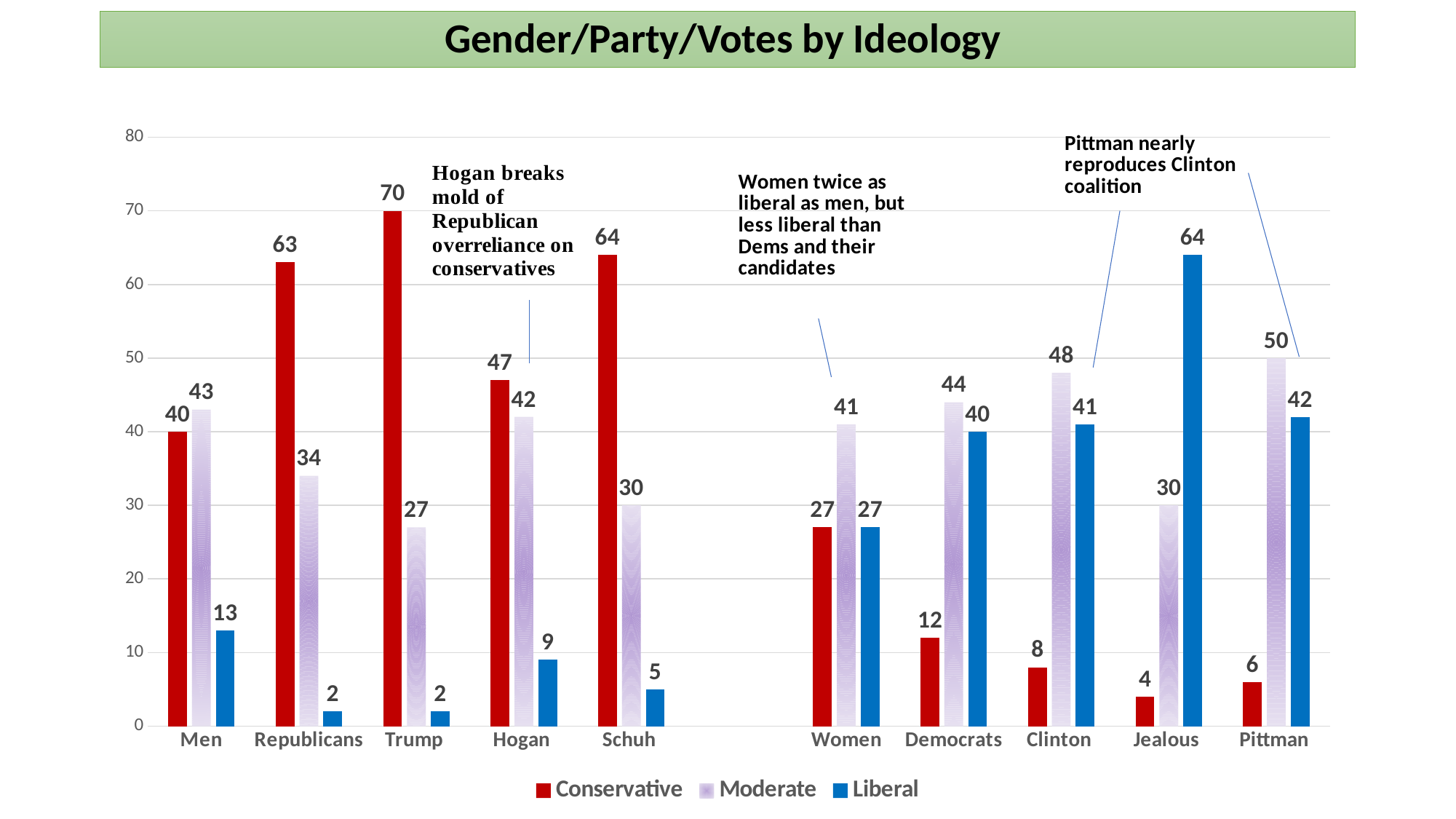
Which category has the lowest Conservative value? Jealous How many labeled categories are shown on the x axis? 10 What kind of chart is shown on the slide? bar chart What is the title of the chart? Gender/Party/Votes by Ideology Which category has the highest Conservative value? Trump How many series does the legend list? 3 What is the Conservative value for Trump? 70 What is the Moderate value for Pittman? 50 What is the Liberal value for Jealous? 64 Which is larger, the Moderate value for Clinton or the Moderate value for Democrats? Clinton Is the Conservative value for Schuh greater or less than 60? greater What is the difference between the Liberal values for Women and Men? 14